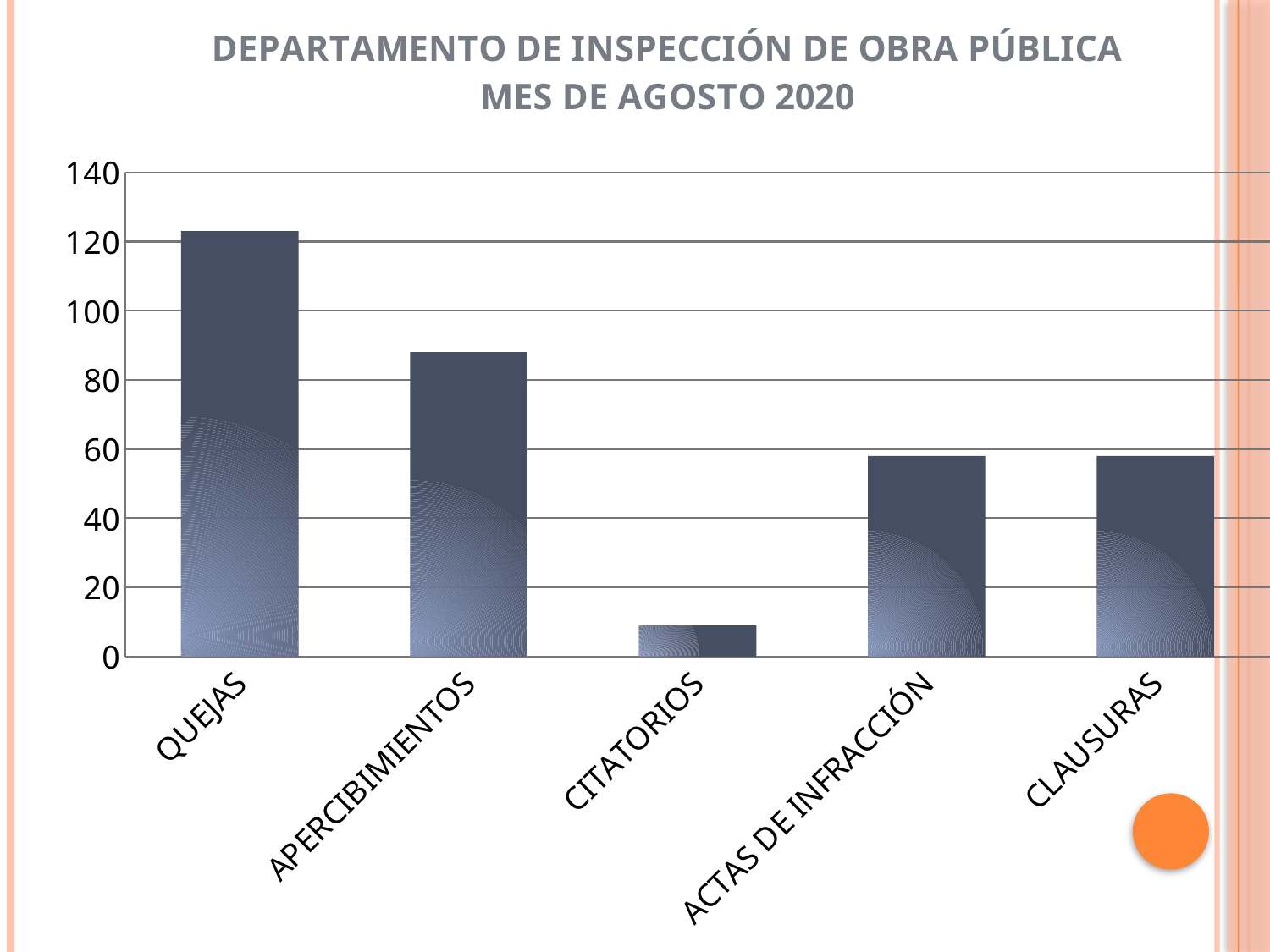
How many categories are shown on the x axis of the chart? 5 Which is larger, the value for QUEJAS or the value for APERCIBIMIENTOS? QUEJAS Which category has the highest value in the chart? QUEJAS Which category has the lowest value in the chart? CITATORIOS Is the value for CITATORIOS greater or less than 20? less What kind of chart is shown on the slide? bar chart Is the value for QUEJAS greater or less than 120? greater What month and year does the chart title say the data is for? AGOSTO 2020 Is the value for APERCIBIMIENTOS greater or less than 100? less Which is larger, the value for CITATORIOS or the value for CLAUSURAS? CLAUSURAS